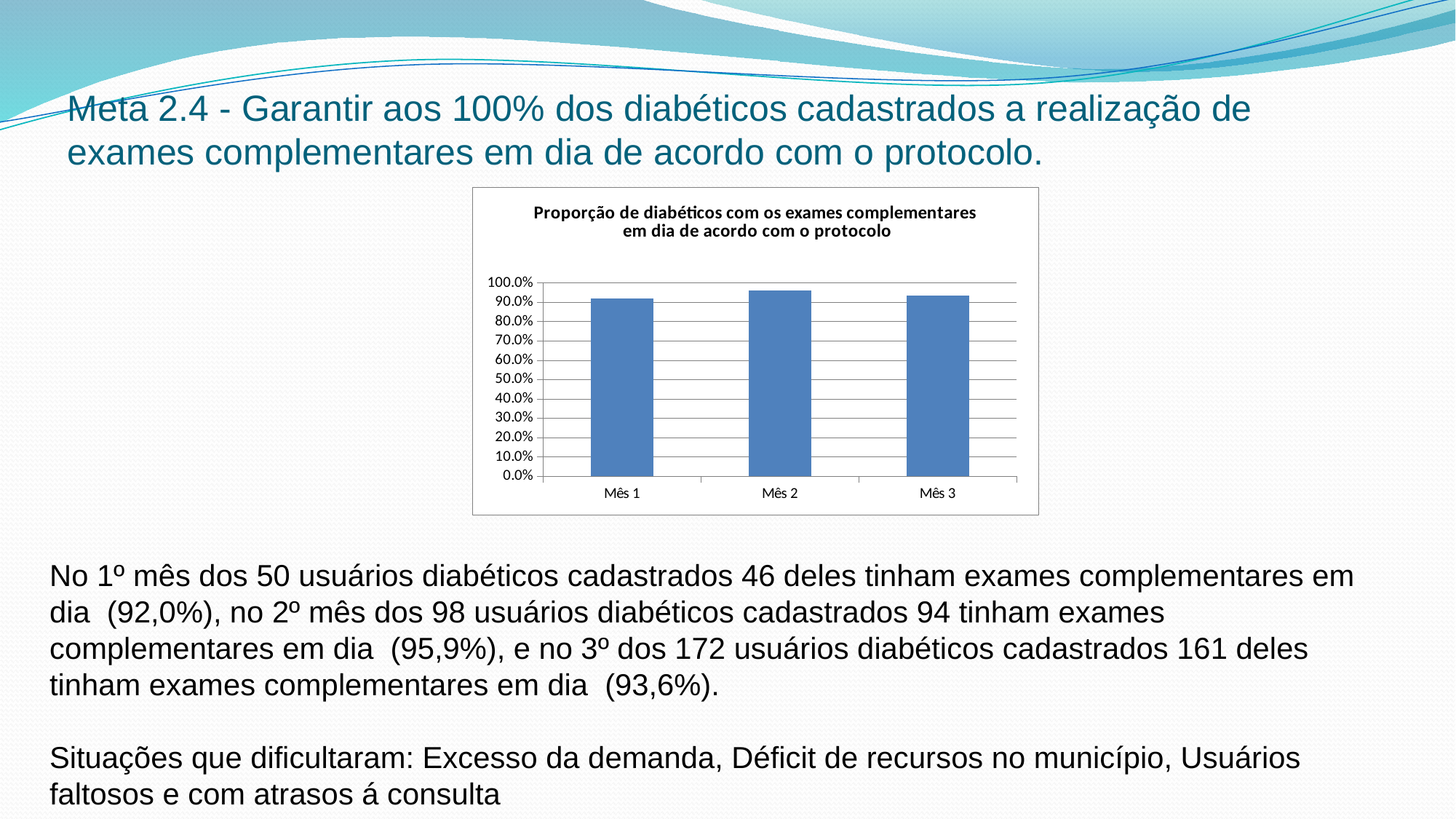
Is the value for Mês 1 greater or less than 90.0%? greater Which month has the highest bar in the chart? Mês 2 Is the value for Mês 2 greater or less than 100.0%? less How many months (categories) are plotted on the x axis of the chart? 3 Which is larger, the value for Mês 2 or the value for Mês 1? Mês 2 Does the value rise or fall from Mês 2 to Mês 3? fall Is the value for Mês 3 greater or less than 80.0%? greater What kind of chart is shown on the slide? Bar chart What is the title of the chart? Proporção de diabéticos com os exames complementares em dia de acordo com o protocolo What colour are the bars in the chart? Blue Does the value rise or fall from Mês 1 to Mês 2? rise Which is larger, the value for Mês 2 or the value for Mês 3? Mês 2